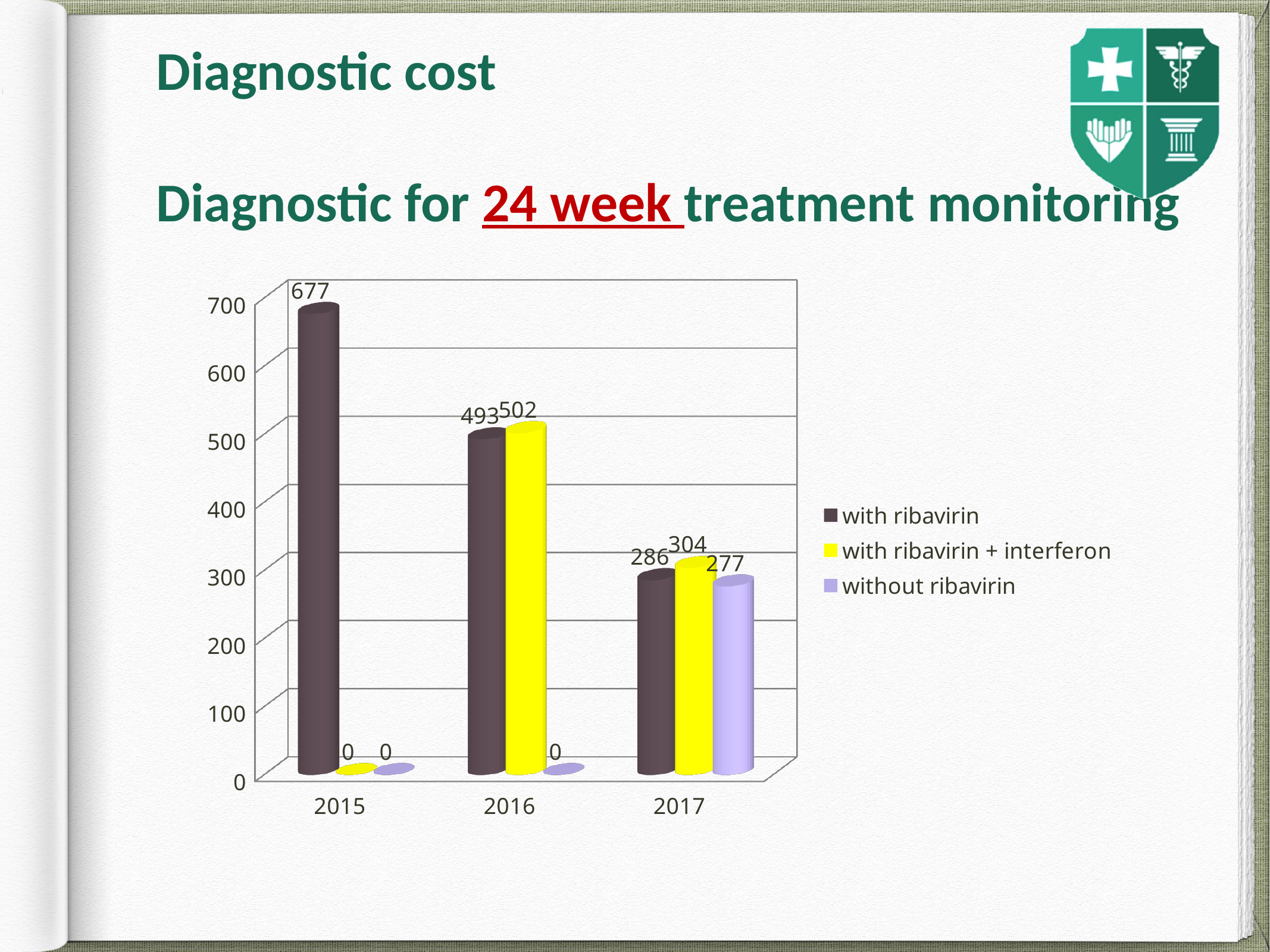
What is the difference between the 'with ribavirin' values for 2015 and 2016? 184 Do the 'with ribavirin' values rise or fall from 2015 to 2017? fall What is the value for 'with ribavirin' in 2017? 286 What is the value for 'with ribavirin' in 2015? 677 How many years are shown on the x axis? 3 How many series does the legend list? 3 Which year has the lowest value for 'with ribavirin'? 2017 What is the value for 'without ribavirin' in 2017? 277 Which year has the highest value for 'with ribavirin'? 2015 What is the value for 'with ribavirin + interferon' in 2016? 502 In 2017, which is larger: 'with ribavirin + interferon' or 'without ribavirin'? with ribavirin + interferon What kind of chart is shown on the slide? bar chart